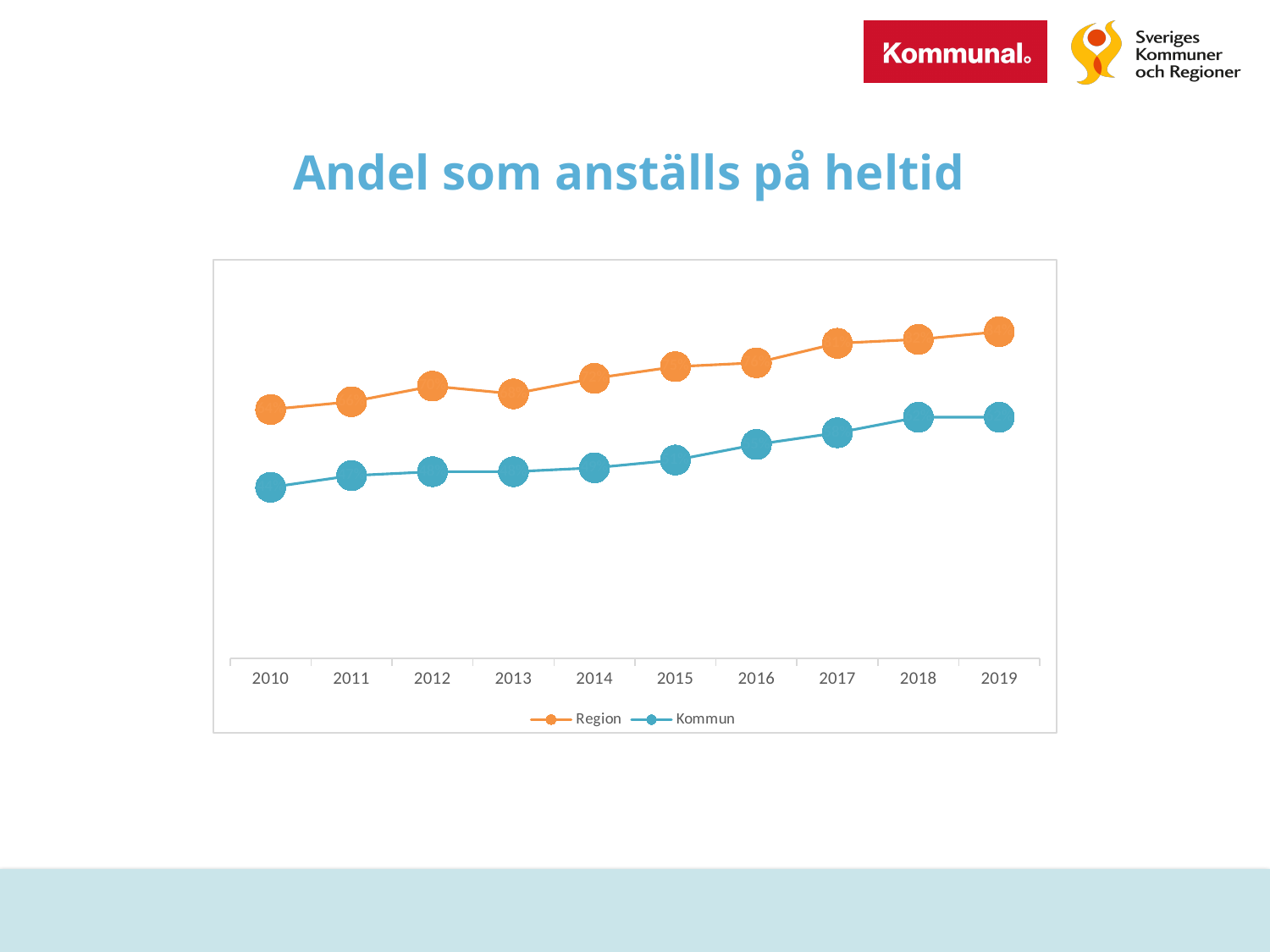
In which year is the Region series at its lowest? 2010 What kind of chart is shown on the slide? line chart Which series has the lower value in 2010, Region or Kommun? Kommun Do the values for Kommun generally rise or fall from 2010 to 2019? rise How many years are shown on the x axis? 10 In which year is the Region series at its highest? 2019 What is the title of the chart on the slide? Andel som anställs på heltid Which series has the higher value in 2015, Region or Kommun? Region Do the values for Region generally rise or fall from 2010 to 2019? rise How many series does the legend list? 2 In which year is the Kommun series at its lowest? 2010 Which colour is used for the Kommun series? blue